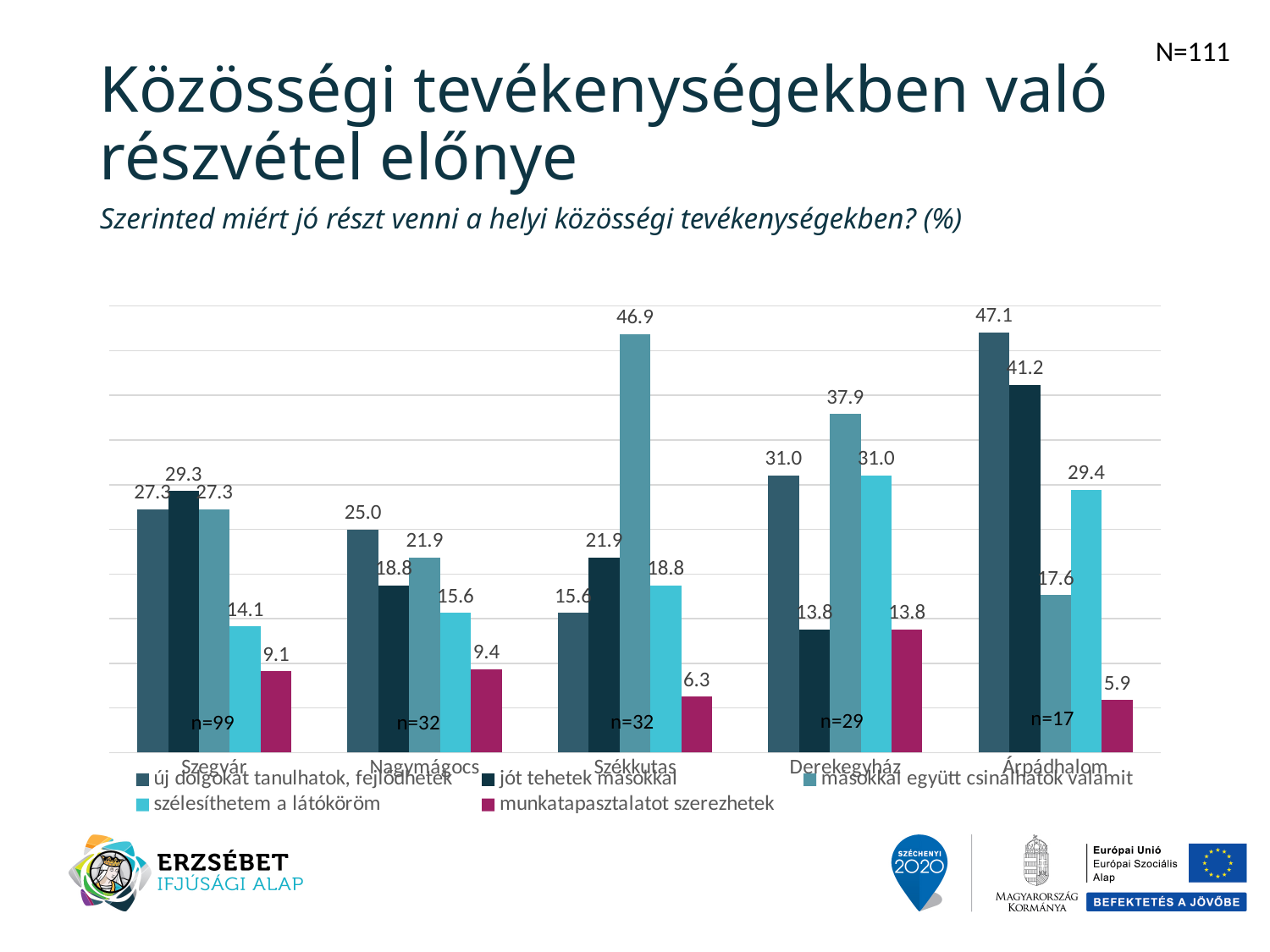
Which settlement has the lowest value for 'munkatapasztalatot szerezhetek'? Árpádhalom What is the difference between 'új dolgokat tanulhatok, fejlődhetek' and 'jót tehetek másokkal' in Árpádhalom? 5.9 What is the sample size (n) shown for Szegvár? n=99 Which settlement has the highest value for 'jót tehetek másokkal'? Árpádhalom How many settlements (categories) are shown on the x axis? 5 What is the value for 'új dolgokat tanulhatok, fejlődhetek' in Árpádhalom? 47.1 How many series does the legend list? 5 What is the value for 'munkatapasztalatot szerezhetek' in Derekegyház? 13.8 What is the value for 'másokkal együtt csinálhatok valamit' in Székkutas? 46.9 What type of chart is shown on the slide? bar chart In Nagymágocs, which is larger: 'új dolgokat tanulhatok, fejlődhetek' or 'másokkal együtt csinálhatok valamit'? új dolgokat tanulhatok, fejlődhetek What is the N value shown in the top right corner of the slide? N=111